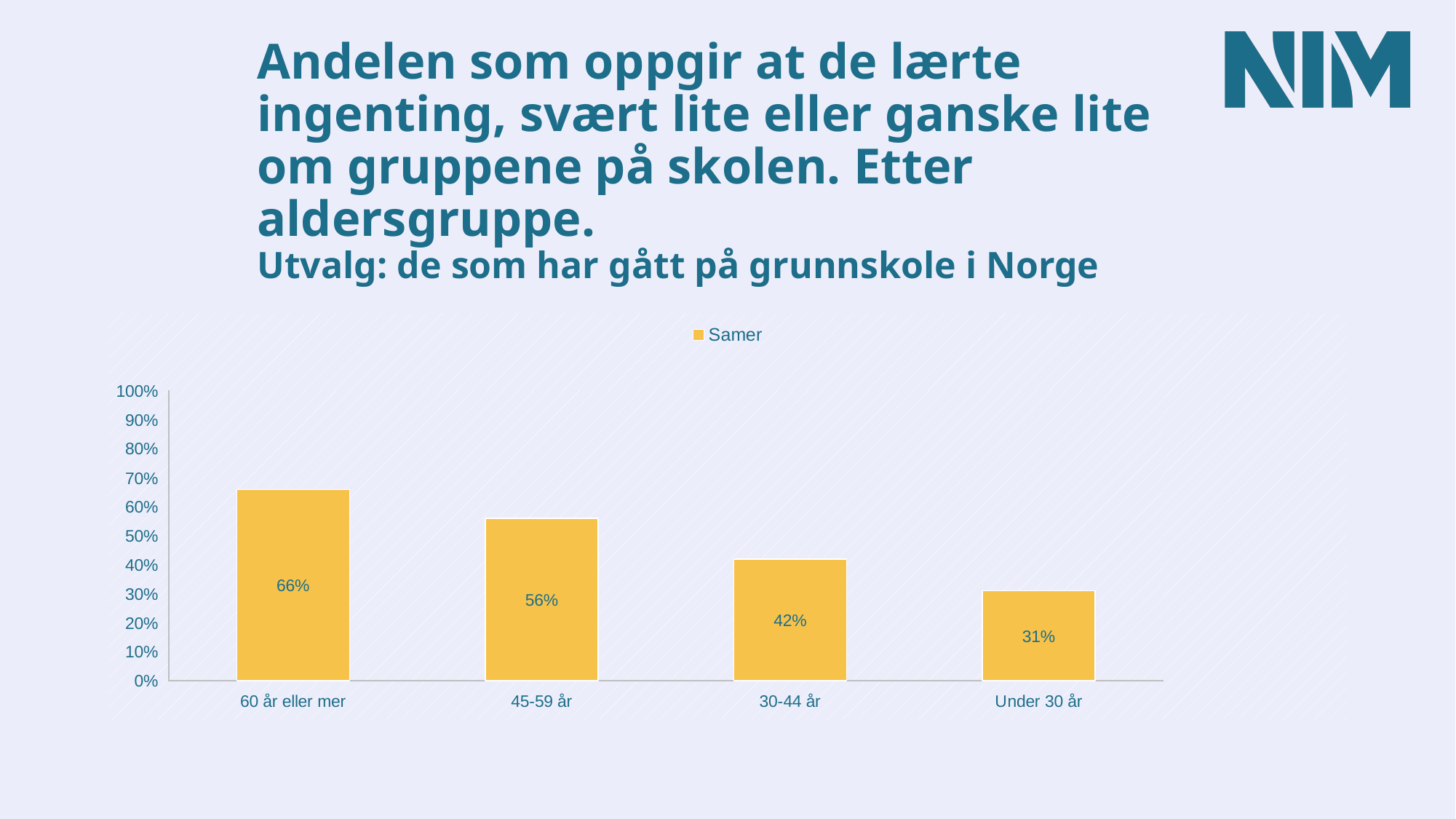
What is the difference between the values for '60 år eller mer' and 'Under 30 år'? 35% What kind of chart is shown on the slide? Bar chart What is the value for the 'Under 30 år' age group? 31% Which is larger, the value for '45-59 år' or the value for '30-44 år'? 45-59 år Is the value for '30-44 år' greater or less than 50%? less What is the value for the '60 år eller mer' age group? 66% How many age groups are shown on the chart? 4 Which age group has the lowest value? Under 30 år Do the values rise or fall from left to right along the x axis? Fall What is the value for the '30-44 år' age group? 42% What is the value for the '45-59 år' age group? 56% Which age group has the highest value? 60 år eller mer